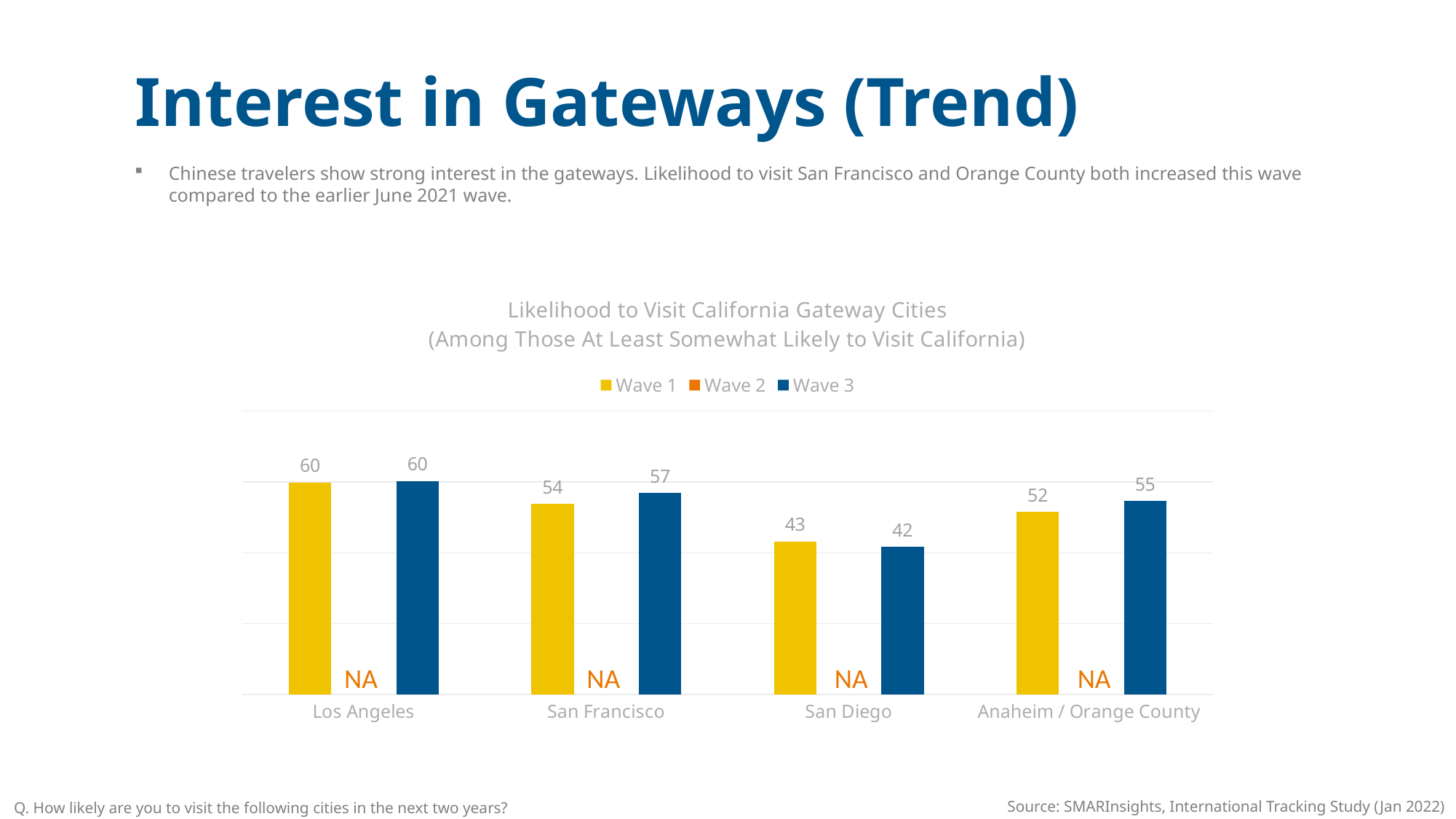
How many cities are shown on the x axis? 4 What is the difference between the Wave 3 and Wave 1 values for San Francisco? 3 Which city has the highest Wave 1 value? Los Angeles What kind of chart is shown? Bar chart What is the Wave 1 value for Los Angeles? 60 What is the Wave 3 value for San Diego? 42 What is the Wave 1 value for Anaheim / Orange County? 52 Which city has the lowest Wave 3 value? San Diego For Anaheim / Orange County, which is larger: the Wave 1 value or the Wave 3 value? Wave 3 What is the Wave 3 value for San Francisco? 57 How many series does the legend list? 3 What value is shown for Wave 2 for each city? NA